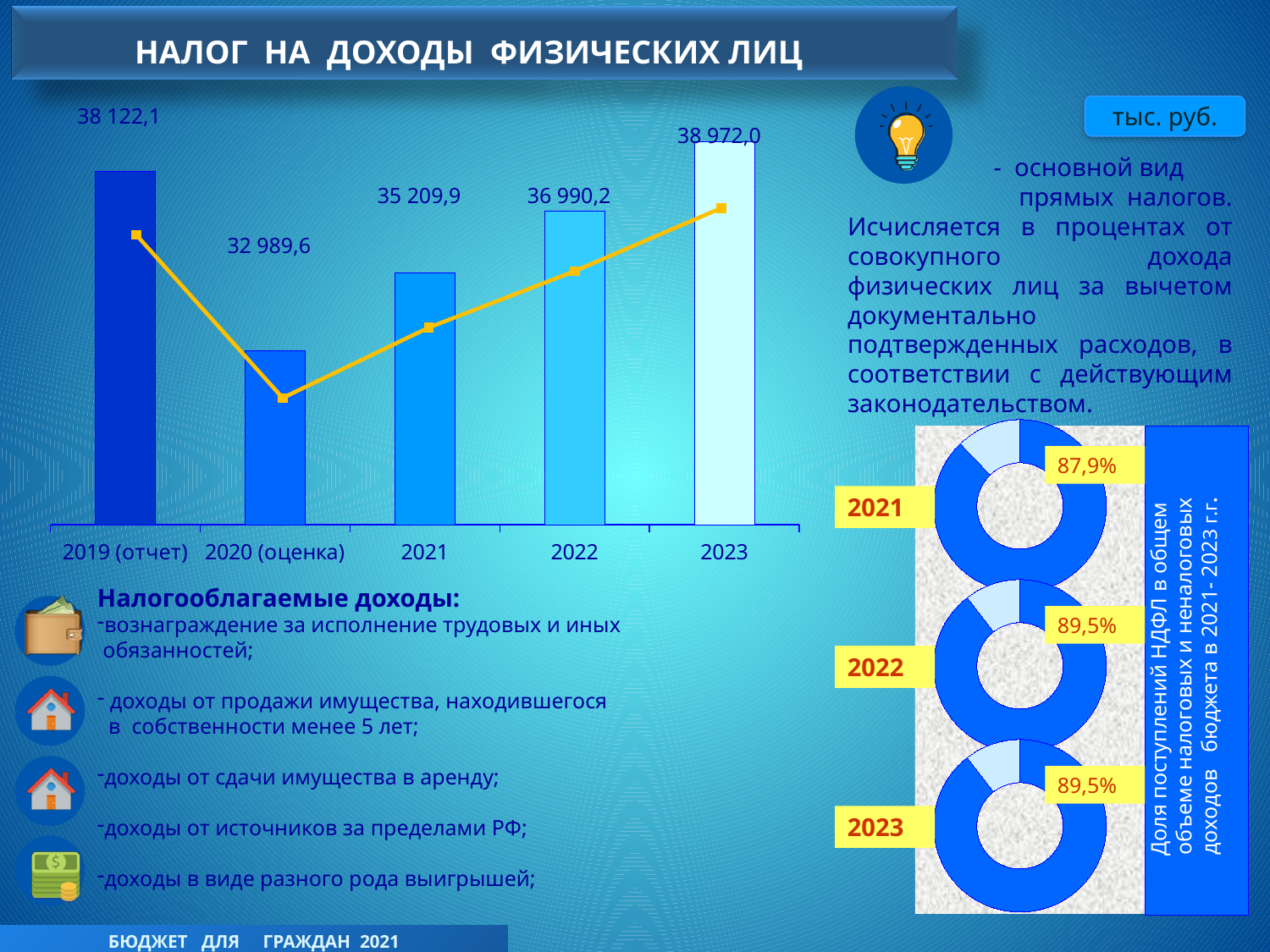
In the donut charts on the right, what is the share of НДФЛ in total tax and non-tax revenues for 2021? 87,9% In the bar chart on the left, what is the value for 2019 (отчет)? 38 122,1 In the bar chart on the left, which year has the lowest value? 2020 (оценка) What unit of measurement is indicated for the bar chart on the left? тыс. руб. In the donut charts on the right, what is the share shown for 2023? 89,5% In the bar chart on the left, which year has the highest value? 2023 How many categories (years) are shown in the bar chart on the left? 5 In the bar chart on the left, which is larger: the value for 2019 (отчет) or the value for 2021? 2019 (отчет) In the bar chart on the left, what is the value for 2020 (оценка)? 32 989,6 In the bar chart on the left, do the values rise or fall from 2020 (оценка) to 2023? rise In the bar chart on the left, what is the value for 2022? 36 990,2 In the bar chart on the left, what is the difference between the values for 2023 and 2022? 1 981,8